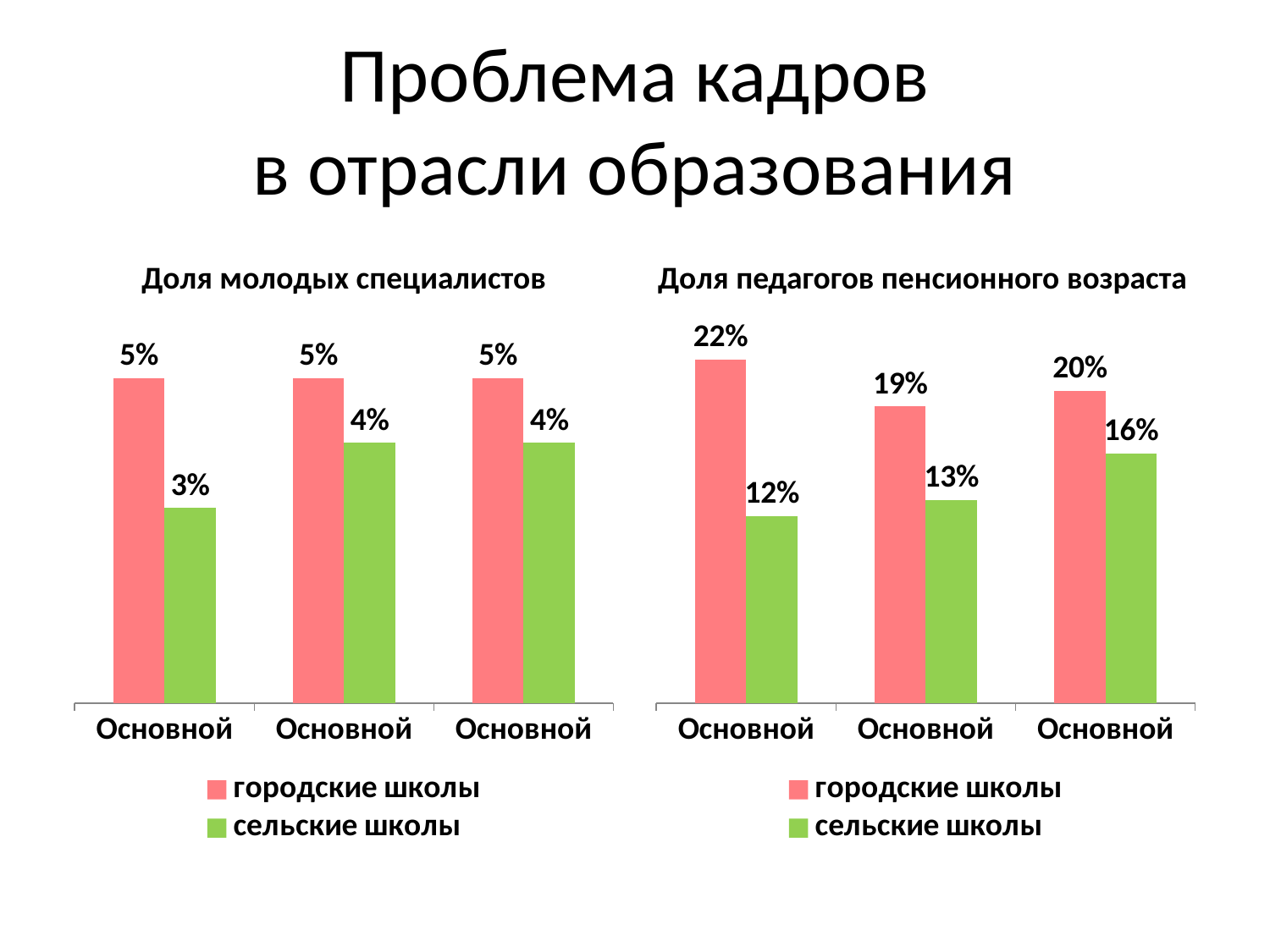
In the chart titled "Доля молодых специалистов", what is the difference between городские школы and сельские школы in the first group of bars? 2% In the chart titled "Доля педагогов пенсионного возраста", what is the value for городские школы in the first group of bars? 22% What kind of chart is the chart titled "Доля педагогов пенсионного возраста"? bar chart In the chart titled "Доля педагогов пенсионного возраста", do the values for сельские школы rise or fall from left to right? rise In the chart titled "Доля педагогов пенсионного возраста", what is the difference between городские школы and сельские школы in the first group of bars? 10% How many series does the legend of the chart titled "Доля молодых специалистов" list? 2 In the chart titled "Доля молодых специалистов", what is the value for сельские школы in the first group of bars? 3% In the chart titled "Доля педагогов пенсионного возраста", what is the value for сельские школы in the third group of bars? 16% In the chart titled "Доля молодых специалистов", what is the value for городские школы in the first group of bars? 5% In the chart titled "Доля педагогов пенсионного возраста", which group of bars has the lowest value for сельские школы? the first group In the chart titled "Доля педагогов пенсионного возраста", which group of bars has the highest value for городские школы? the first group In the chart titled "Доля педагогов пенсионного возраста", which is larger in the second group of bars: городские школы or сельские школы? городские школы